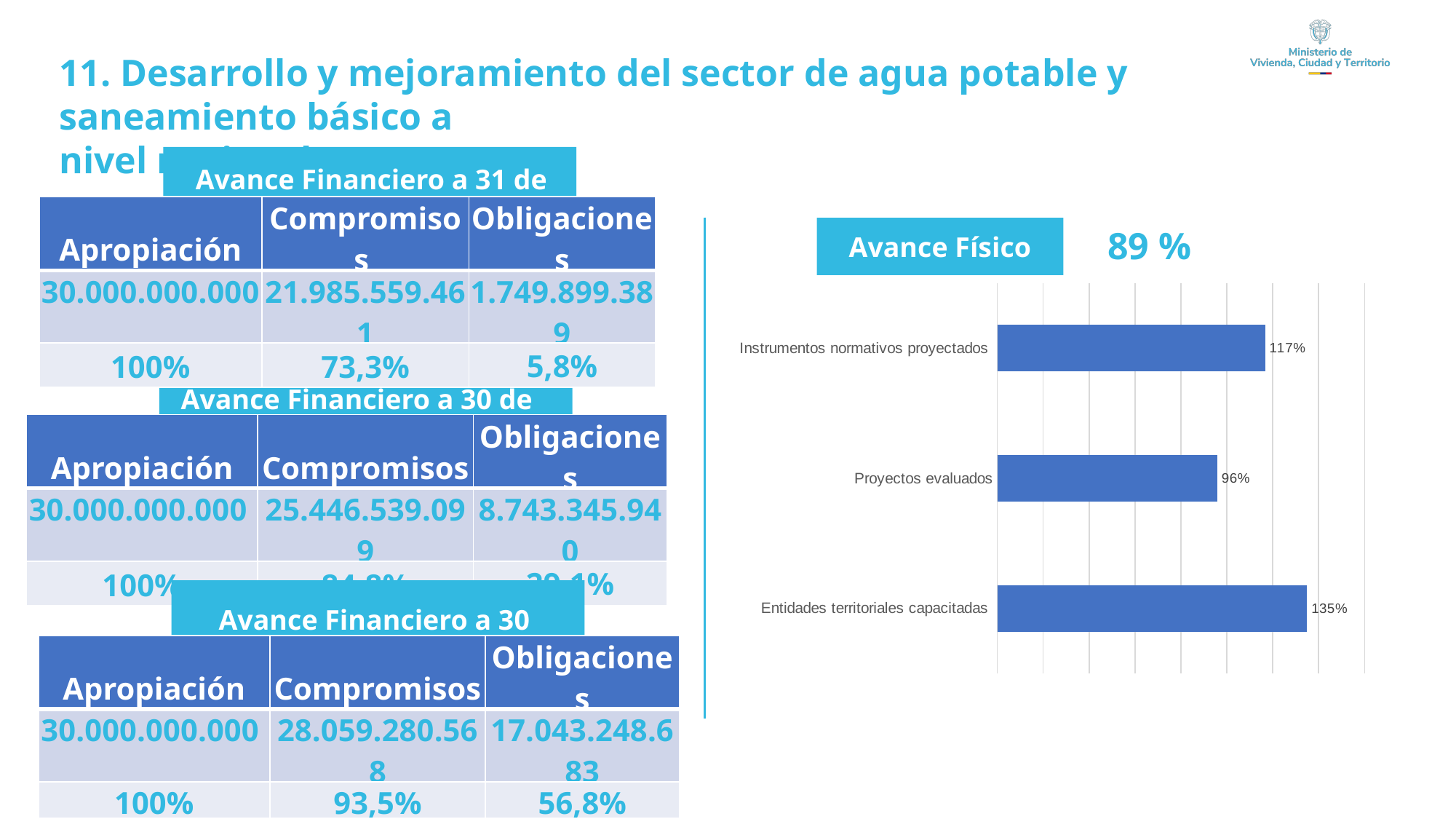
What is the value for Entidades territoriales capacitadas in the bar chart? 135% What is the difference between the values for Instrumentos normativos proyectados and Proyectos evaluados? 21% What is the difference between the values for Entidades territoriales capacitadas and Proyectos evaluados? 39% Which is larger in the bar chart: Instrumentos normativos proyectados or Entidades territoriales capacitadas? Entidades territoriales capacitadas What kind of chart is shown on the right side of the slide? Bar chart What is the value for Proyectos evaluados in the bar chart? 96% What is the title shown above the bar chart? Avance Físico How many categories are shown in the bar chart? 3 Which category has the highest value in the bar chart? Entidades territoriales capacitadas What is the value for Instrumentos normativos proyectados in the bar chart? 117% Which is larger in the bar chart: Proyectos evaluados or Instrumentos normativos proyectados? Instrumentos normativos proyectados Which category has the lowest value in the bar chart? Proyectos evaluados